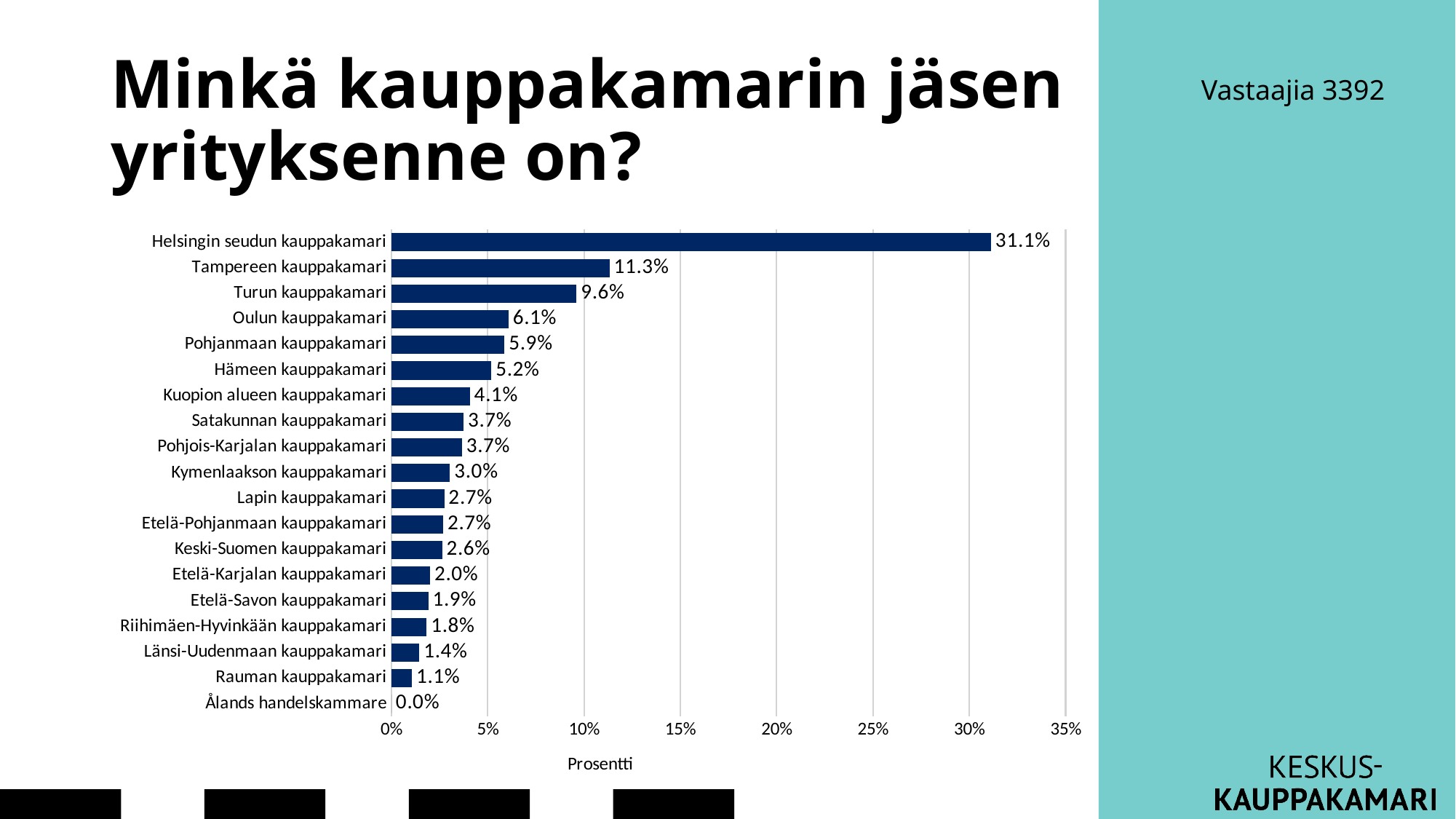
What is the value for Kymenlaakson kauppakamari? 3.0% Which category has the lowest value? Ålands handelskammare How many categories are shown in the chart? 19 Which category has the highest value? Helsingin seudun kauppakamari Which is larger, the value for Pohjanmaan kauppakamari or the value for Hämeen kauppakamari? Pohjanmaan kauppakamari What kind of chart is shown on the slide? bar chart What is the label of the horizontal axis? Prosentti What is the difference between the values for Tampereen kauppakamari and Turun kauppakamari? 1.7% Is the value for Tampereen kauppakamari greater or less than 10%? greater What is the value for Helsingin seudun kauppakamari? 31.1% What is the value for Oulun kauppakamari? 6.1% What is the value for Rauman kauppakamari? 1.1%